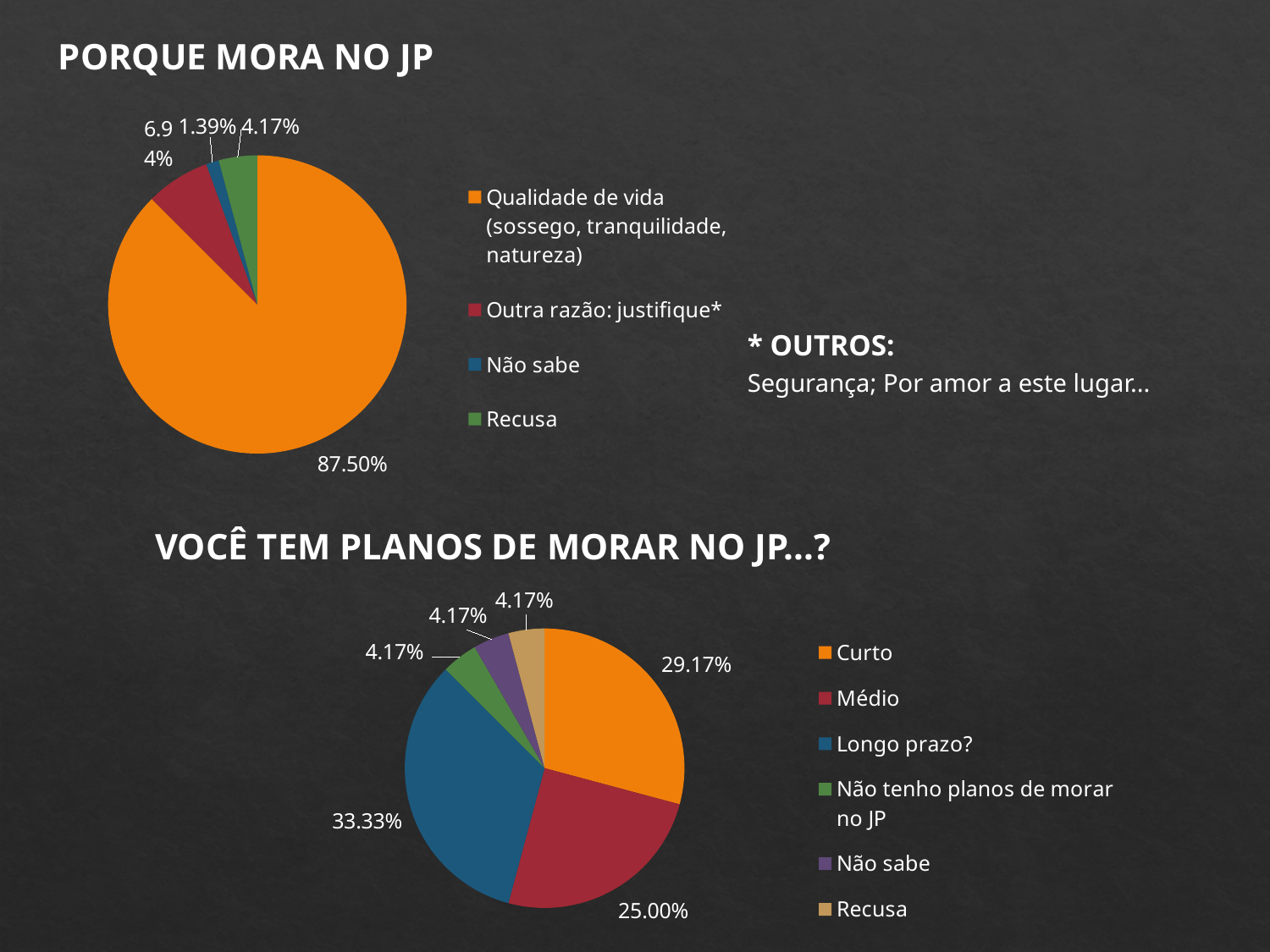
In the 'VOCÊ TEM PLANOS DE MORAR NO JP...?' chart, what share is labelled for 'Longo prazo?'? 33.33% What kind of chart is used for 'PORQUE MORA NO JP'? Pie chart In the 'PORQUE MORA NO JP' chart, what share is labelled for 'Recusa'? 4.17% In the 'VOCÊ TEM PLANOS DE MORAR NO JP...?' chart, which is larger: 'Curto' or 'Médio'? Curto In the 'VOCÊ TEM PLANOS DE MORAR NO JP...?' chart, what share is labelled for 'Médio'? 25.00% In the 'PORQUE MORA NO JP' chart, what share is labelled for 'Não sabe'? 1.39% In the 'VOCÊ TEM PLANOS DE MORAR NO JP...?' chart, how many categories does the legend list? 6 In the 'VOCÊ TEM PLANOS DE MORAR NO JP...?' chart, what is the difference between the 'Longo prazo?' share and the 'Curto' share? 4.16% In the 'PORQUE MORA NO JP' chart, how many categories does the legend list? 4 In the 'PORQUE MORA NO JP' chart, what share is labelled for 'Qualidade de vida (sossego, tranquilidade, natureza)'? 87.50% In the 'PORQUE MORA NO JP' chart, which category has the smallest slice? Não sabe In the 'VOCÊ TEM PLANOS DE MORAR NO JP...?' chart, which category has the largest slice? Longo prazo?